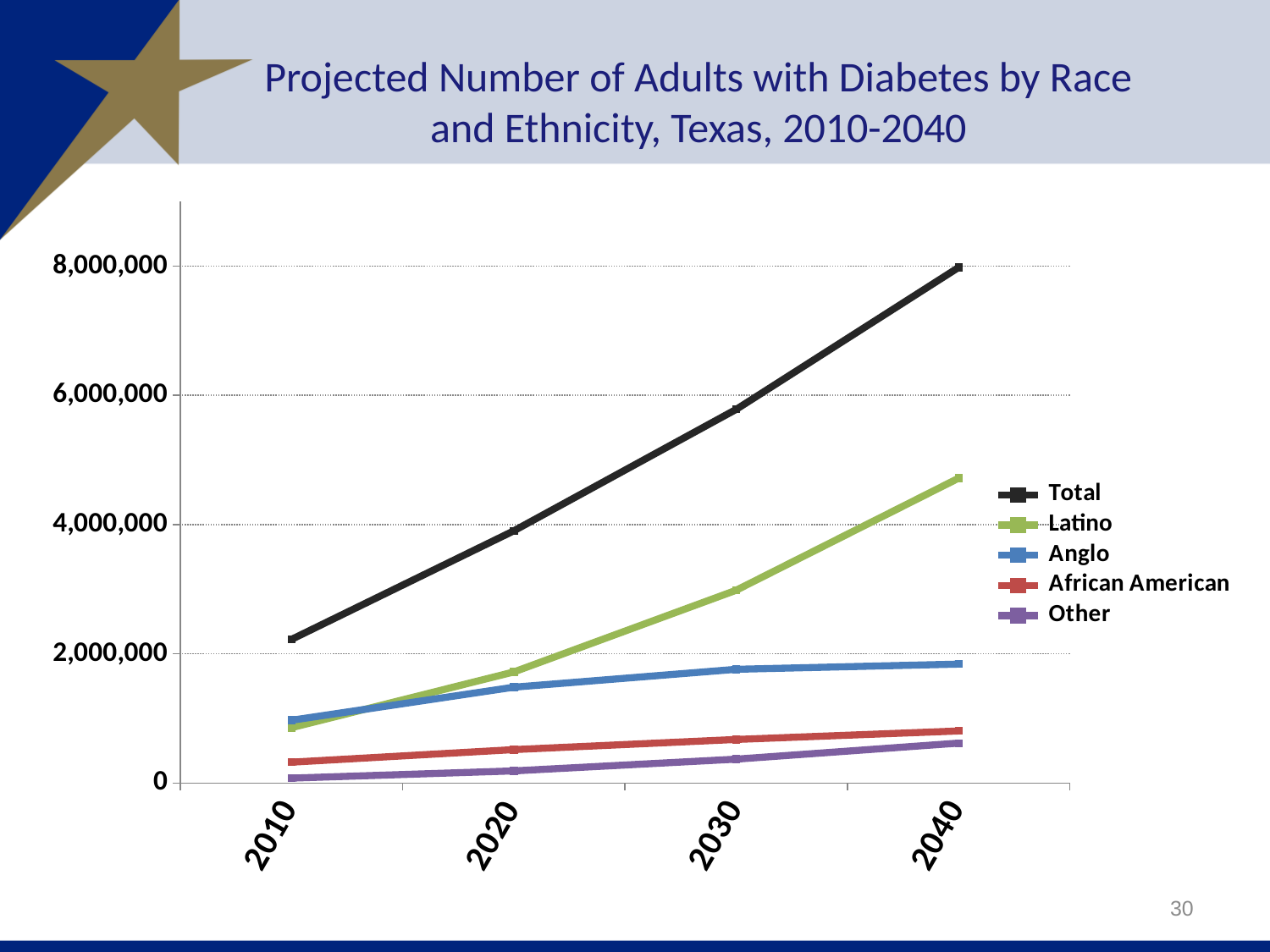
Does the Total series rise or fall from 2010 to 2040? rise What is the title of the chart? Projected Number of Adults with Diabetes by Race and Ethnicity, Texas, 2010-2040 What kind of chart is shown on the slide? line chart In 2040, which is larger: Latino or Anglo? Latino How many series does the legend list? 5 How many years are plotted along the x axis? 4 Is the value for Total in 2030 greater or less than 6,000,000? less Which series has the lowest value in 2040? Other Is the value for Latino in 2040 greater or less than 4,000,000? greater Which series has the highest value in 2040? Total Is the value for Latino in 2030 greater or less than 4,000,000? less